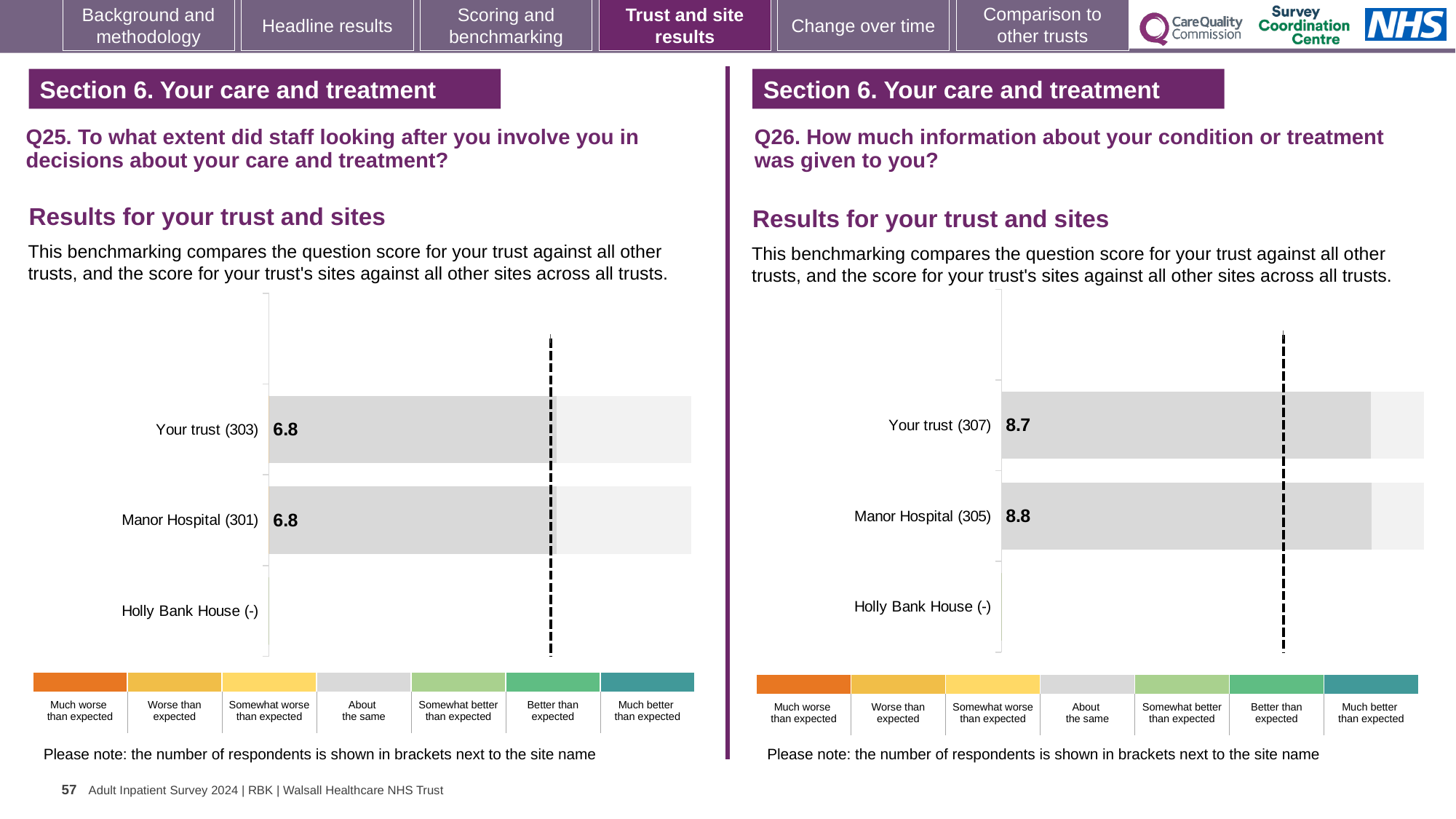
In the Q26 chart on the right, what is the score for Your trust? 8.7 How many benchmark categories are shown in the colour legend below the Q25 chart on the left? 7 In the Q25 chart on the left, what is the score for Manor Hospital? 6.8 In the Q26 chart on the right, what is the difference between the Manor Hospital score and the Your trust score? 0.1 What type of chart is used for the Q26 results on the right? Bar chart In the Q25 chart on the left, how many respondents are shown in brackets for Your trust? 303 In the Q26 chart on the right, which has the higher score, Your trust or Manor Hospital? Manor Hospital In the Q26 chart on the right, what is the score for Manor Hospital? 8.8 How many categories (rows) are listed on the y axis of the Q25 chart on the left? 3 In the Q25 chart on the left, what is the score for Your trust? 6.8 In the Q26 chart on the right, how many respondents are shown in brackets for Manor Hospital? 305 In the Q25 chart on the left, which site has no score shown (marked with a dash)? Holly Bank House